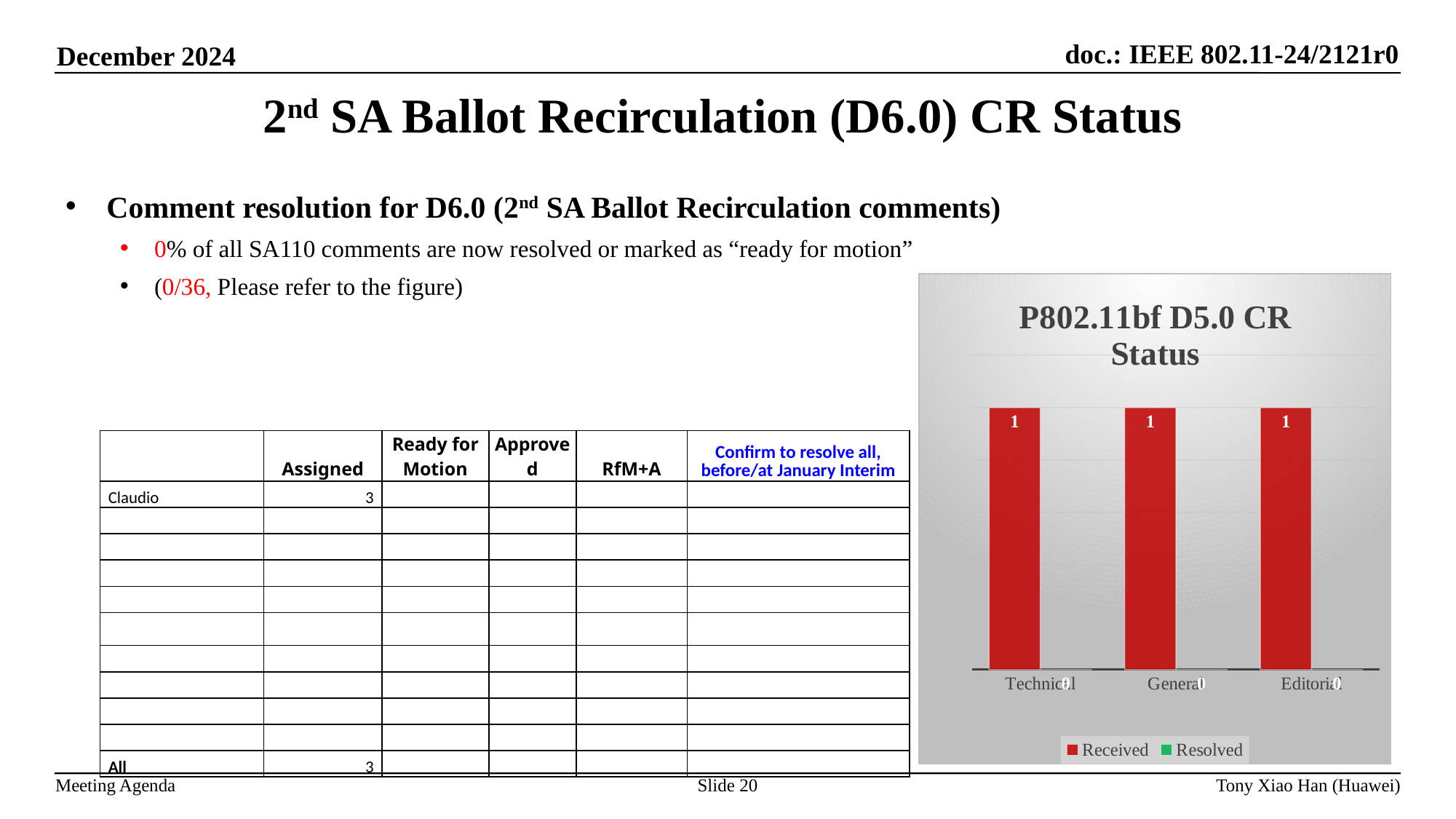
What is the title of the chart on the slide? P802.11bf D5.0 CR Status For the Editorial category, which is larger, Received or Resolved? Received What are the two series named in the chart legend? Received and Resolved What is the Received value for the Editorial category? 1 What is the Received value for the Technical category? 1 What is the Received value for the General category? 1 What kind of chart is shown on the slide? bar chart What is the Resolved value for the Technical category? 0 How many categories are shown on the x axis of the chart? 3 Do the Received values rise, fall, or stay the same across Technical, General and Editorial? stay the same What is the difference between Received and Resolved for the General category? 1 How many series does the chart legend list? 2